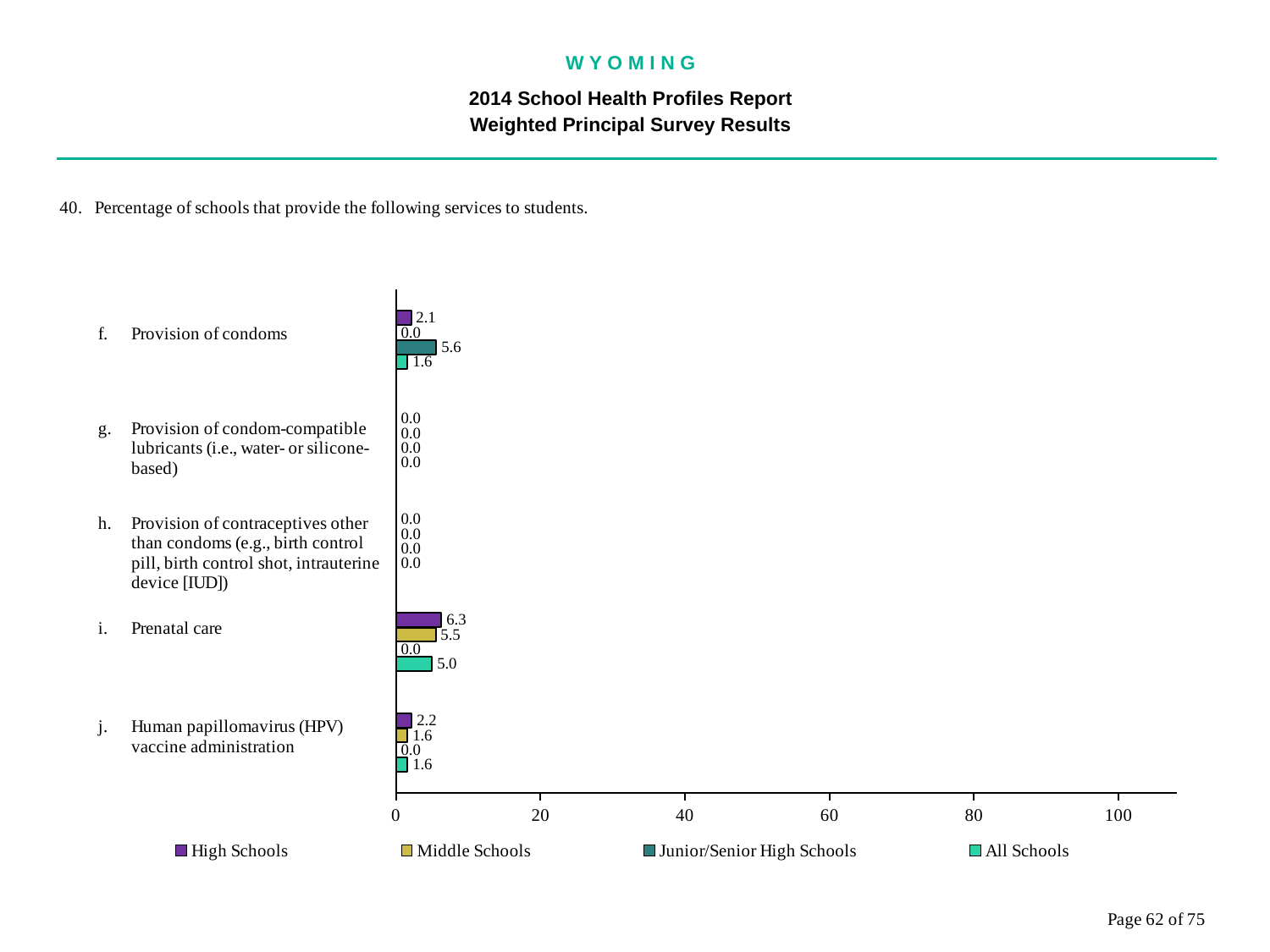
How many service categories are shown on the chart? 5 What is the value for Middle Schools for Prenatal care? 5.5 Which series has the highest value for Prenatal care? High Schools What is the value for High Schools for Provision of condoms? 2.1 What is the value for Junior/Senior High Schools for Provision of condoms? 5.6 What is the difference between the High Schools and All Schools values for Prenatal care? 1.3 What is the value for All Schools for Human papillomavirus (HPV) vaccine administration? 1.6 Which is larger for High Schools: Prenatal care or Human papillomavirus (HPV) vaccine administration? Prenatal care How many series does the legend list? 4 Which series has the highest value for Provision of condoms? Junior/Senior High Schools What kind of chart is shown on the slide? Bar chart What is the difference between the Junior/Senior High Schools and High Schools values for Provision of condoms? 3.5